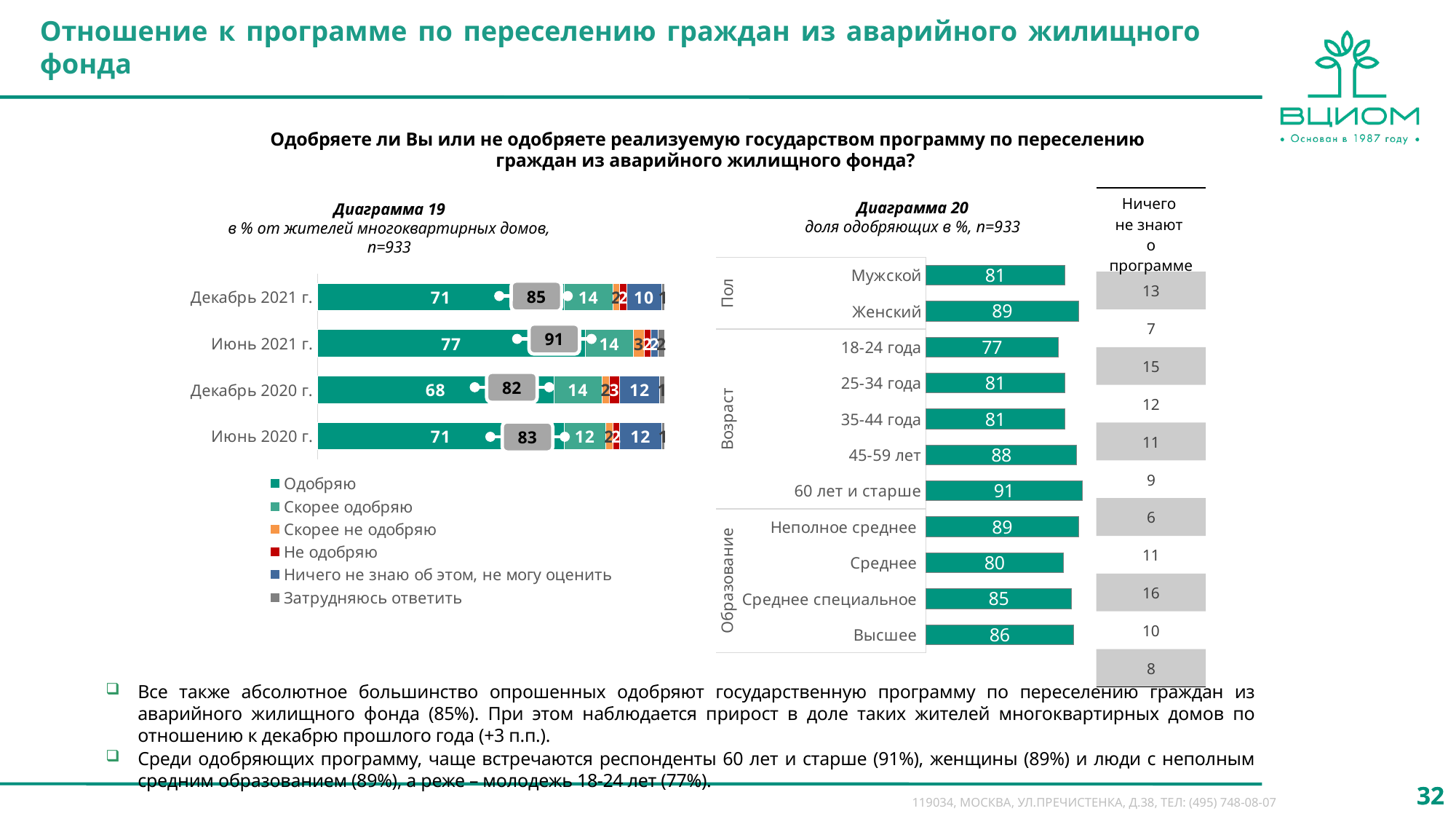
In Диаграмма 20, what is the share of approving respondents among women (Женский)? 89 In Диаграмма 20, which has a larger approval share: Среднее специальное or Высшее? Высшее In Диаграмма 19, which period has the highest value for the Одобряю segment? Июнь 2021 г. How many series does the legend of Диаграмма 19 list? 6 What type of chart is Диаграмма 19? Stacked bar chart In Диаграмма 20, which category has the highest share of approving respondents? 60 лет и старше In Диаграмма 19, what is the value of the Одобряю segment for Июнь 2021 г.? 77 In Диаграмма 19, what is the value of the Ничего не знаю об этом, не могу оценить segment for Декабрь 2020 г.? 12 In Диаграмма 20, what is the difference between the approval share for 60 лет и старше and for 18-24 года? 14 How many categories are plotted in Диаграмма 20? 11 In Диаграмма 19, what is the difference between the Одобряю values for Июнь 2021 г. and Декабрь 2020 г.? 9 In Диаграмма 20, which category has the lowest share of approving respondents? 18-24 года